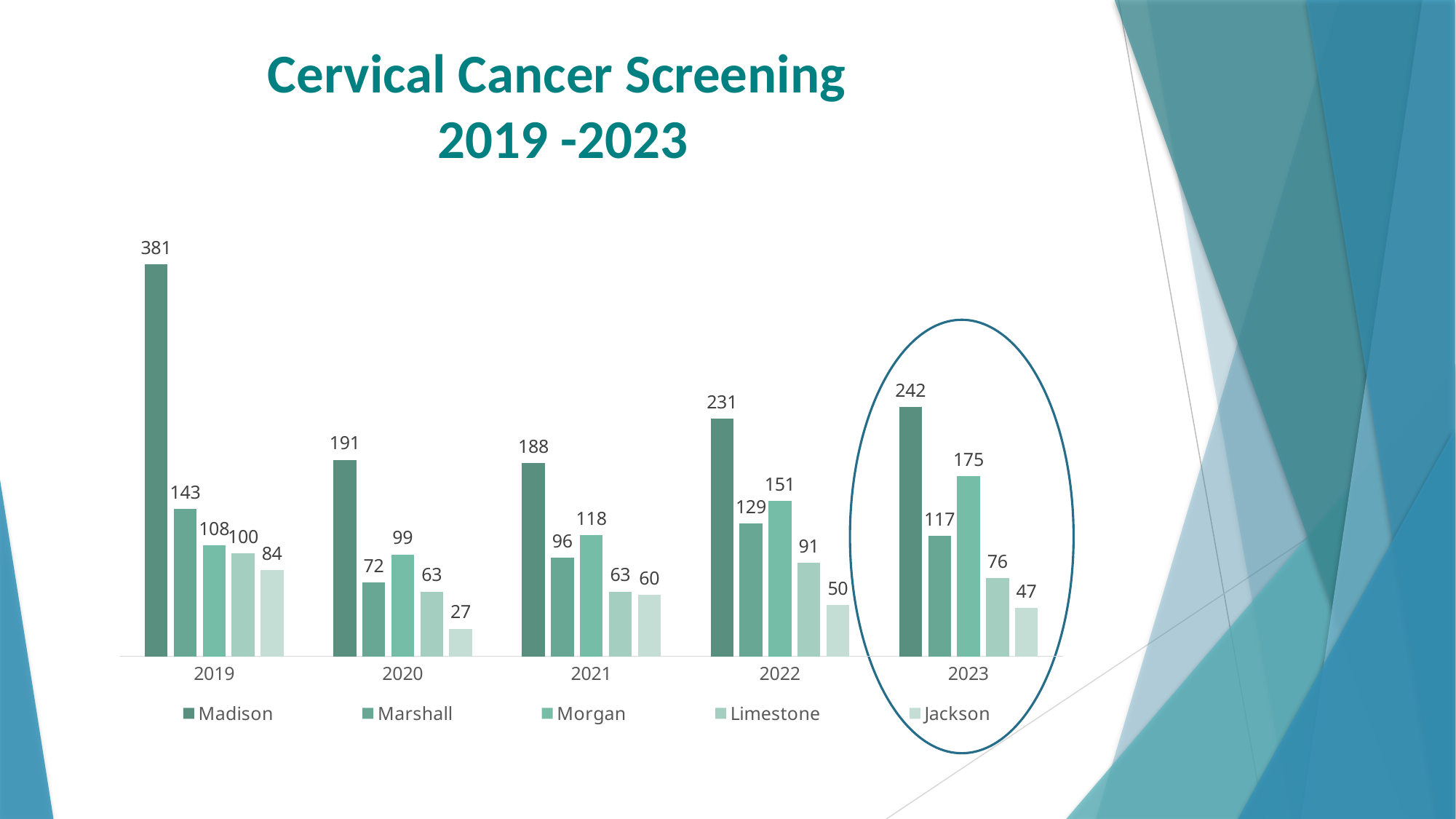
What is the value for Madison in 2019? 381 What is the title of the chart? Cervical Cancer Screening 2019 -2023 How many years are shown on the x axis? 5 What kind of chart is shown on the slide? Bar chart What is the value for Morgan in 2023? 175 Which is larger in 2022, the value for Marshall or the value for Morgan? Morgan Which year has the highest value for Madison? 2019 What is the difference between the Madison values in 2019 and 2023? 139 Which year has the lowest value for Jackson? 2020 What is the value for Jackson in 2020? 27 Does the value for Morgan rise or fall from 2022 to 2023? Rise How many series does the legend list? 5